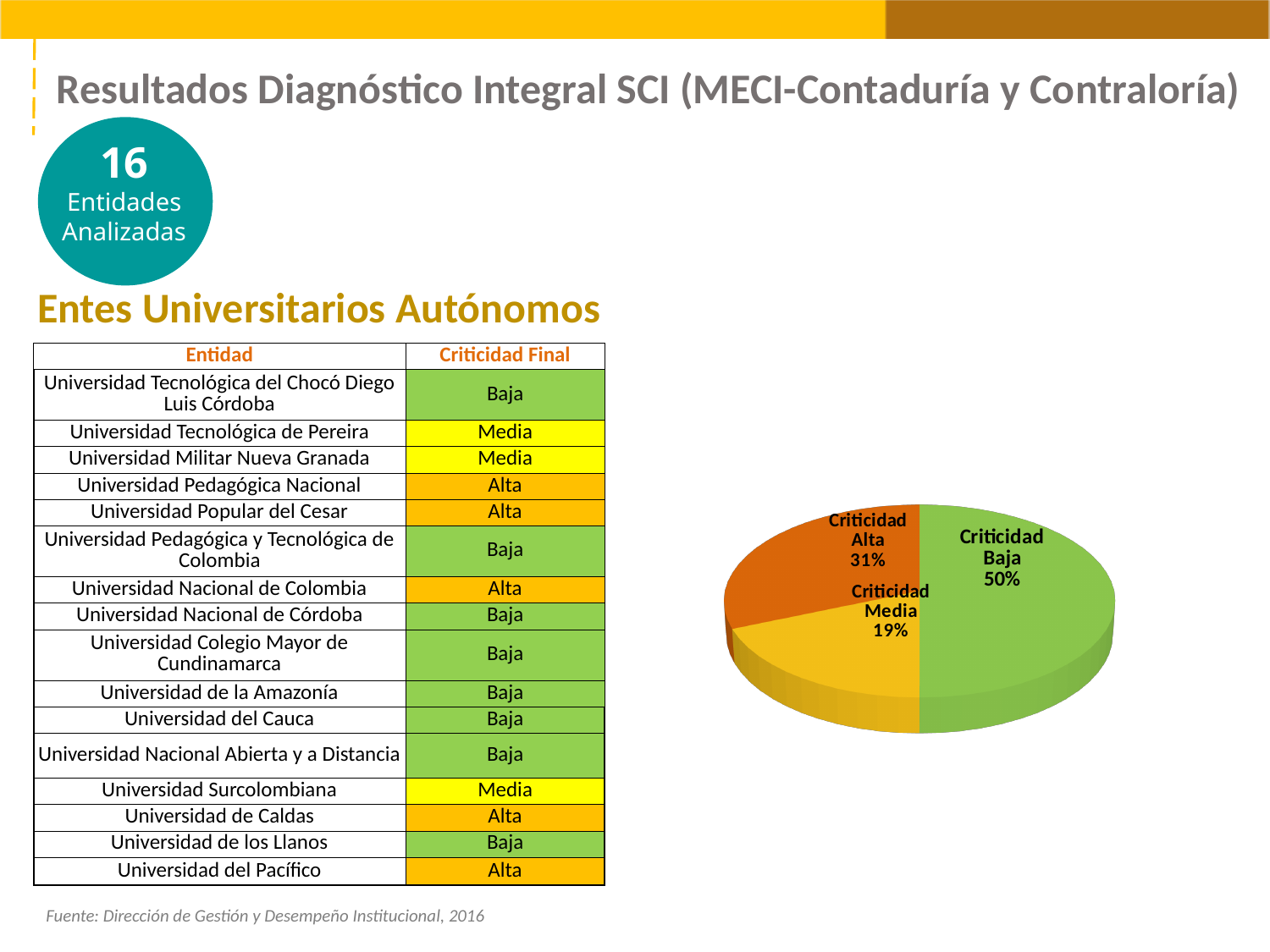
What is the difference in percentage points between Criticidad Alta and Criticidad Media in the pie chart? 12 What colour is the Criticidad Baja slice in the pie chart? Green What is the difference in percentage points between Criticidad Baja and Criticidad Alta in the pie chart? 19 Which category has the smallest slice in the pie chart? Criticidad Media What kind of chart is shown on the slide? Pie chart What share of the pie chart does Criticidad Alta represent? 31% Which category has the largest slice in the pie chart? Criticidad Baja What share of the pie chart does Criticidad Media represent? 19% What colour is the Criticidad Alta slice in the pie chart? Orange What share of the pie chart does Criticidad Baja represent? 50% How many slices does the pie chart have? 3 Which is larger in the pie chart, Criticidad Alta or Criticidad Media? Criticidad Alta